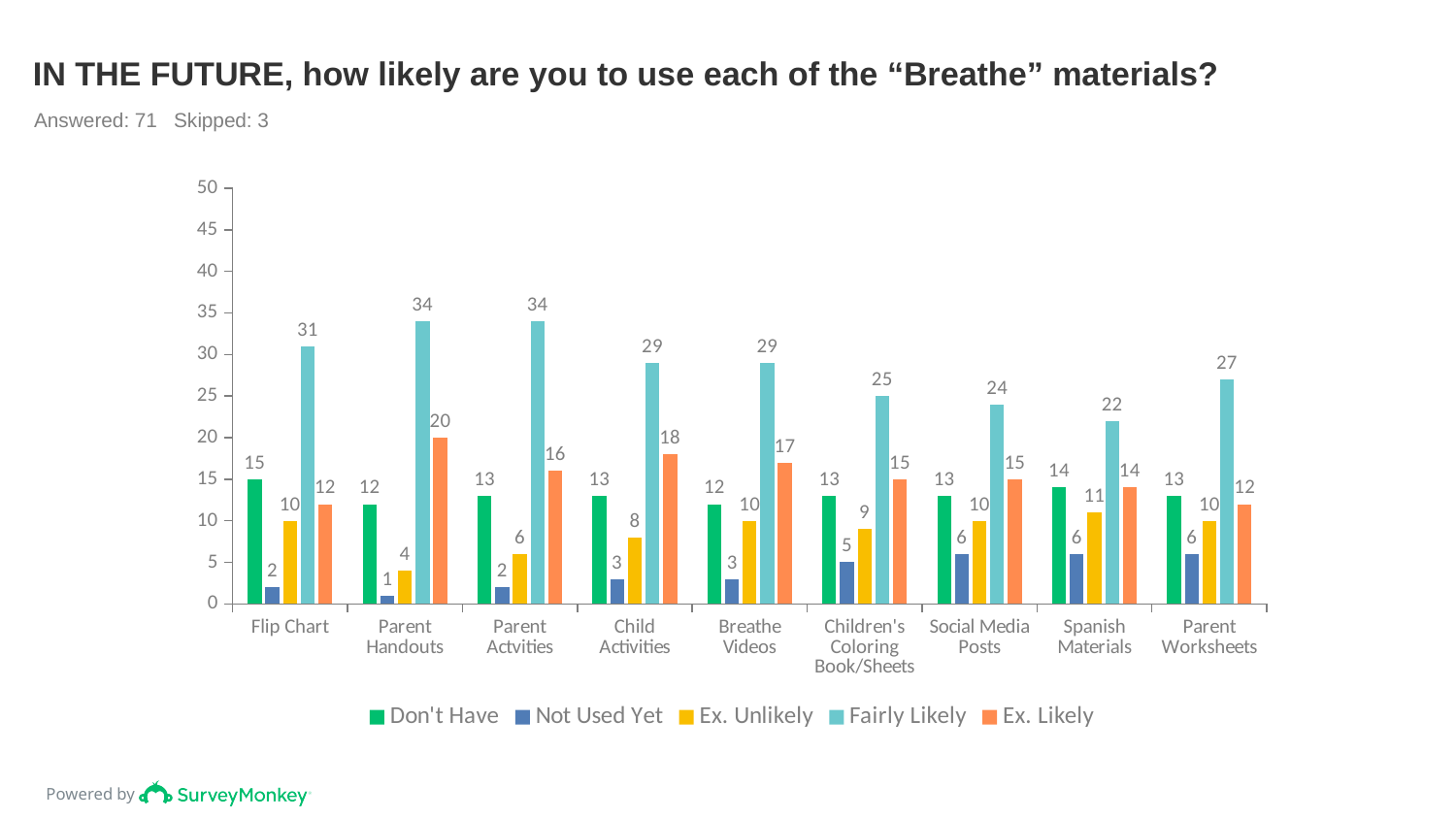
What is the difference between the Fairly Likely and Ex. Likely values for Breathe Videos? 12 Which category has the highest Ex. Likely value? Parent Handouts What is the Fairly Likely value for Flip Chart? 31 How many respondents answered the question, according to the slide? 71 What kind of chart is shown on the slide? Bar chart What is the Ex. Likely value for Parent Handouts? 20 How many series does the legend list? 5 Which is larger for Social Media Posts: the Don't Have value or the Ex. Unlikely value? Don't Have Which category has the lowest Fairly Likely value? Spanish Materials What is the Ex. Unlikely value for Child Activities? 8 How many categories are shown on the x axis? 9 What is the Not Used Yet value for Spanish Materials? 6